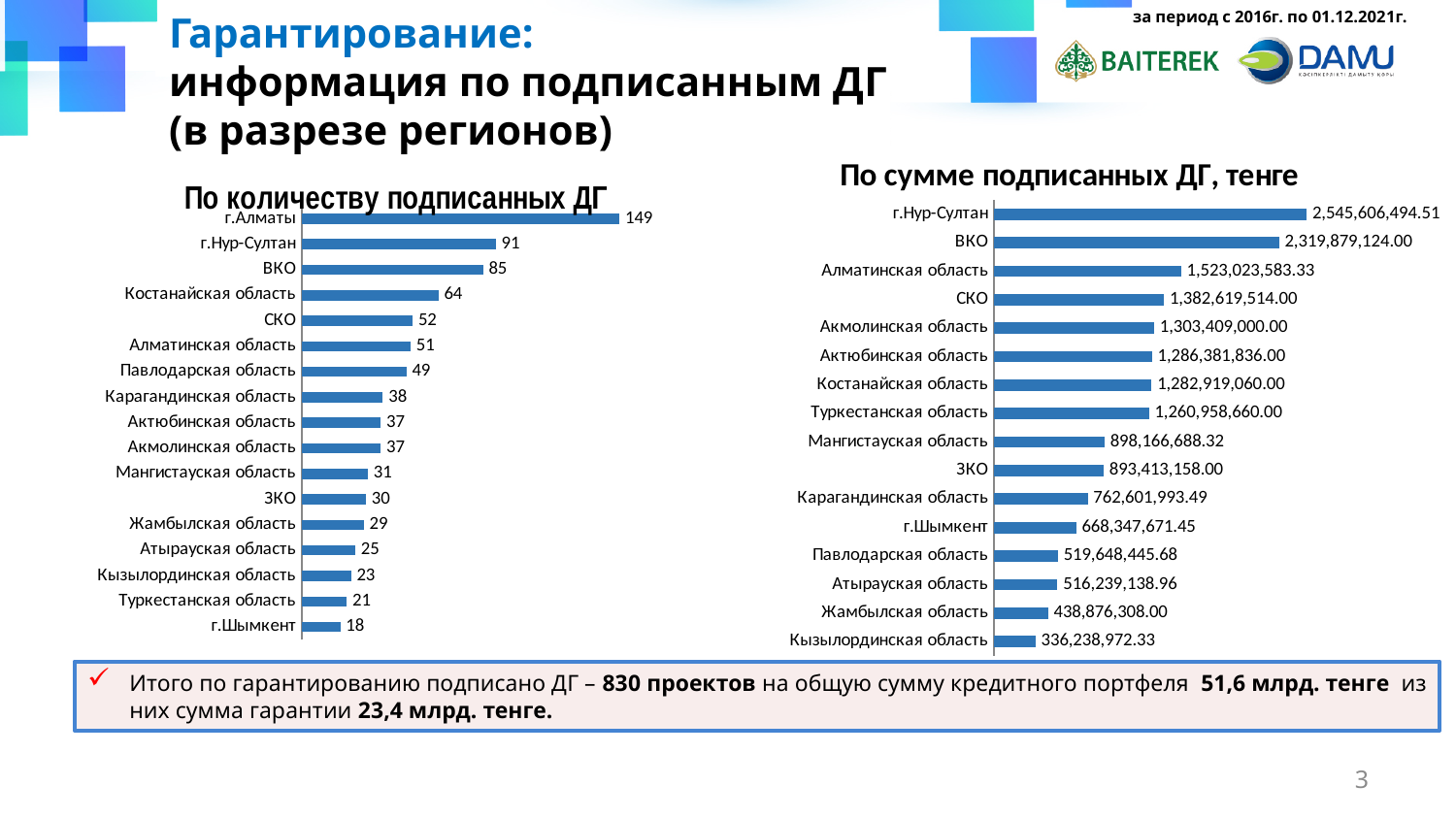
In the chart 'По количеству подписанных ДГ', which is larger: СКО or Павлодарская область? СКО In the chart 'По сумме подписанных ДГ, тенге', which category has the lowest value? Кызылординская область What type of chart is 'По сумме подписанных ДГ, тенге'? Bar chart In the chart 'По количеству подписанных ДГ', what is the value for г.Алматы? 149 In the chart 'По количеству подписанных ДГ', what is the difference between г.Алматы and г.Нур-Султан? 58 In the chart 'По количеству подписанных ДГ', which category has the lowest value? г.Шымкент In the chart 'По количеству подписанных ДГ', what is the value for Костанайская область? 64 In the chart 'По сумме подписанных ДГ, тенге', how many categories are shown? 16 In the chart 'По сумме подписанных ДГ, тенге', what is the value for г.Шымкент? 668,347,671.45 In the chart 'По количеству подписанных ДГ', how many categories are shown? 17 In the chart 'По сумме подписанных ДГ, тенге', which category has the highest value? г.Нур-Султан In the chart 'По сумме подписанных ДГ, тенге', what is the value for ВКО? 2,319,879,124.00